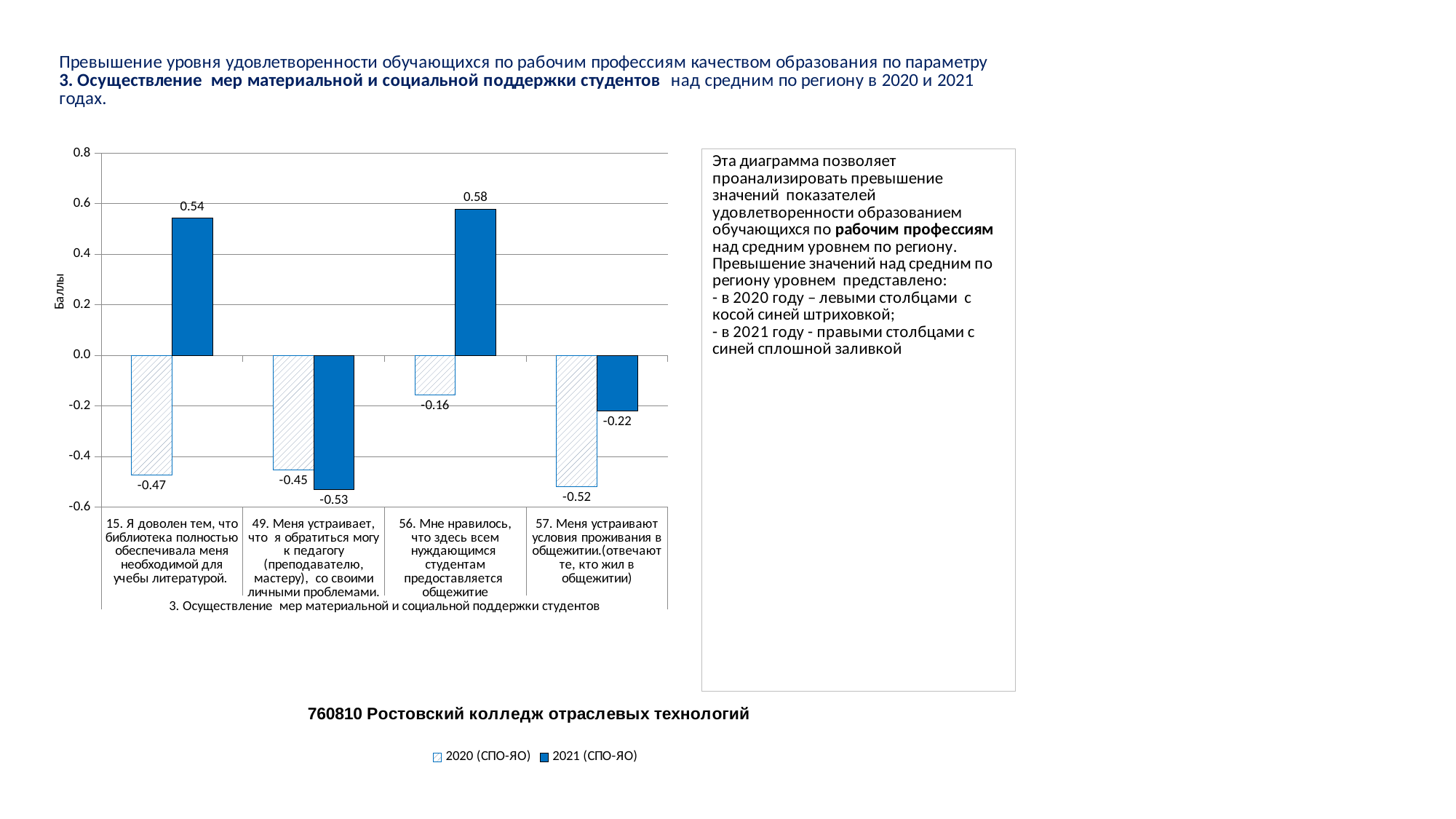
Какое значение показано для 2020 (СПО-ЯО) по пункту «56. Мне нравилось, что здесь всем нуждающимся студентам предоставляется общежитие»? -0.16 Сколько пунктов (категорий) показано на диаграмме? 4 Сколько рядов данных указано в легенде диаграммы? 2 Как называется ось Y на диаграмме? Баллы Какое значение больше: 2020 (СПО-ЯО) или 2021 (СПО-ЯО) по пункту 49? 2020 (СПО-ЯО) Какое значение показано для 2020 (СПО-ЯО) по пункту «49. Меня устраивает, что я обратиться могу к педагогу ... со своими личными проблемами»? -0.45 Какое значение показано для 2021 (СПО-ЯО) по пункту «15. Я доволен тем, что библиотека полностью обеспечивала меня необходимой для учебы литературой»? 0.54 Какое значение показано для 2021 (СПО-ЯО) по пункту «57. Меня устраивают условия проживания в общежитии»? -0.22 На сколько значение 2021 (СПО-ЯО) по пункту 56 больше значения 2021 (СПО-ЯО) по пункту 15? 0.04 Какого типа эта диаграмма? Столбчатая (bar chart) По какому пункту значение 2021 (СПО-ЯО) самое высокое? 56. Мне нравилось, что здесь всем нуждающимся студентам предоставляется общежитие По какому пункту значение 2020 (СПО-ЯО) самое низкое? 57. Меня устраивают условия проживания в общежитии